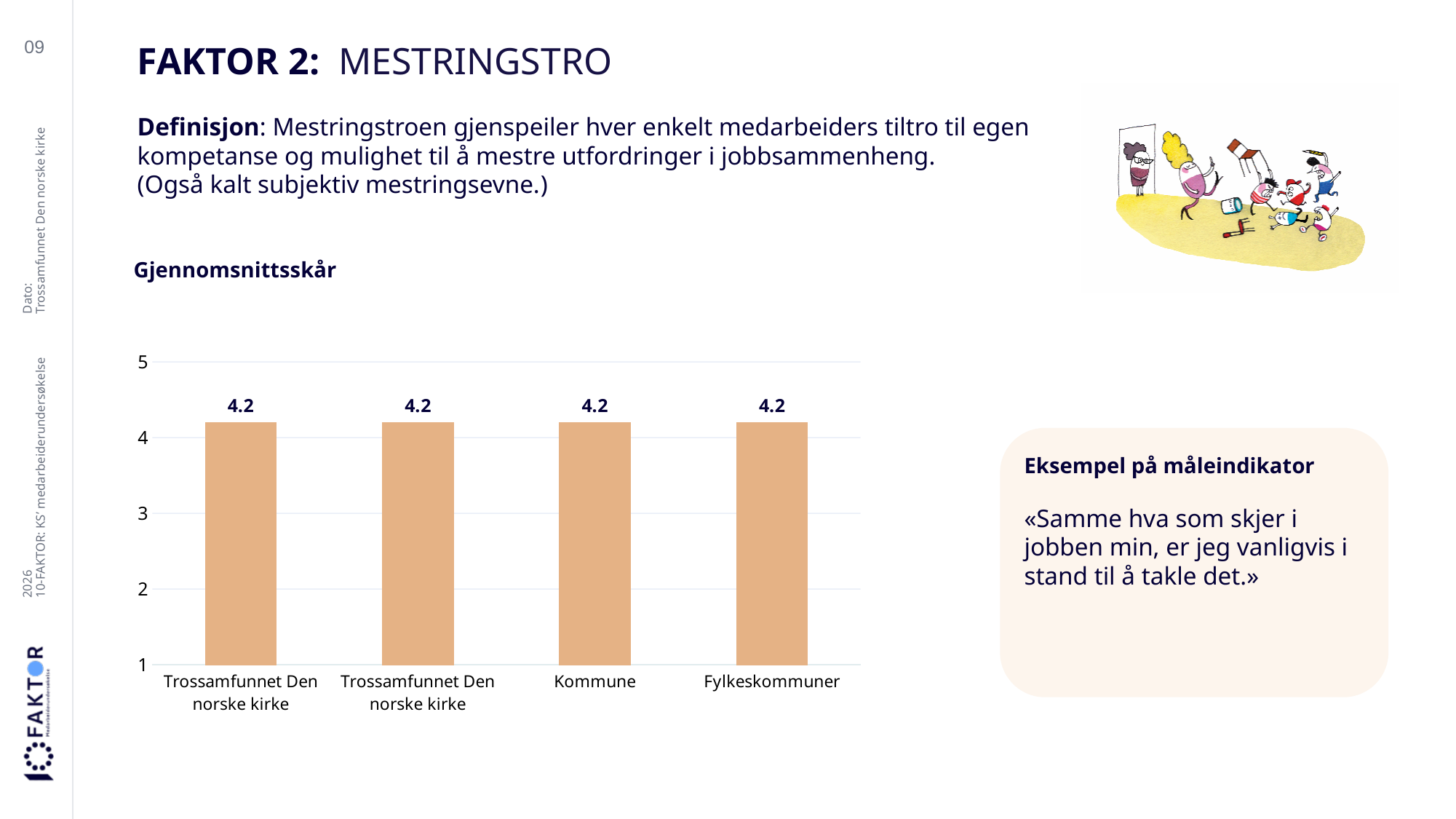
Do the values rise, fall or stay the same across the categories from left to right? Stay the same What is the difference between the values for Kommune and Fylkeskommuner? 0 What value is shown for Trossamfunnet Den norske kirke in the chart? 4.2 What is the highest value shown on the chart's vertical axis? 5 How many bars are shown in the chart? 4 What is the value for Kommune in the Gjennomsnittsskår chart? 4.2 Is the value for Kommune greater or less than 4? greater What is the value for Fylkeskommuner in the Gjennomsnittsskår chart? 4.2 What is the title of the chart? Gjennomsnittsskår What kind of chart is shown on the slide? Bar chart Is the value for Fylkeskommuner greater or less than 5? less